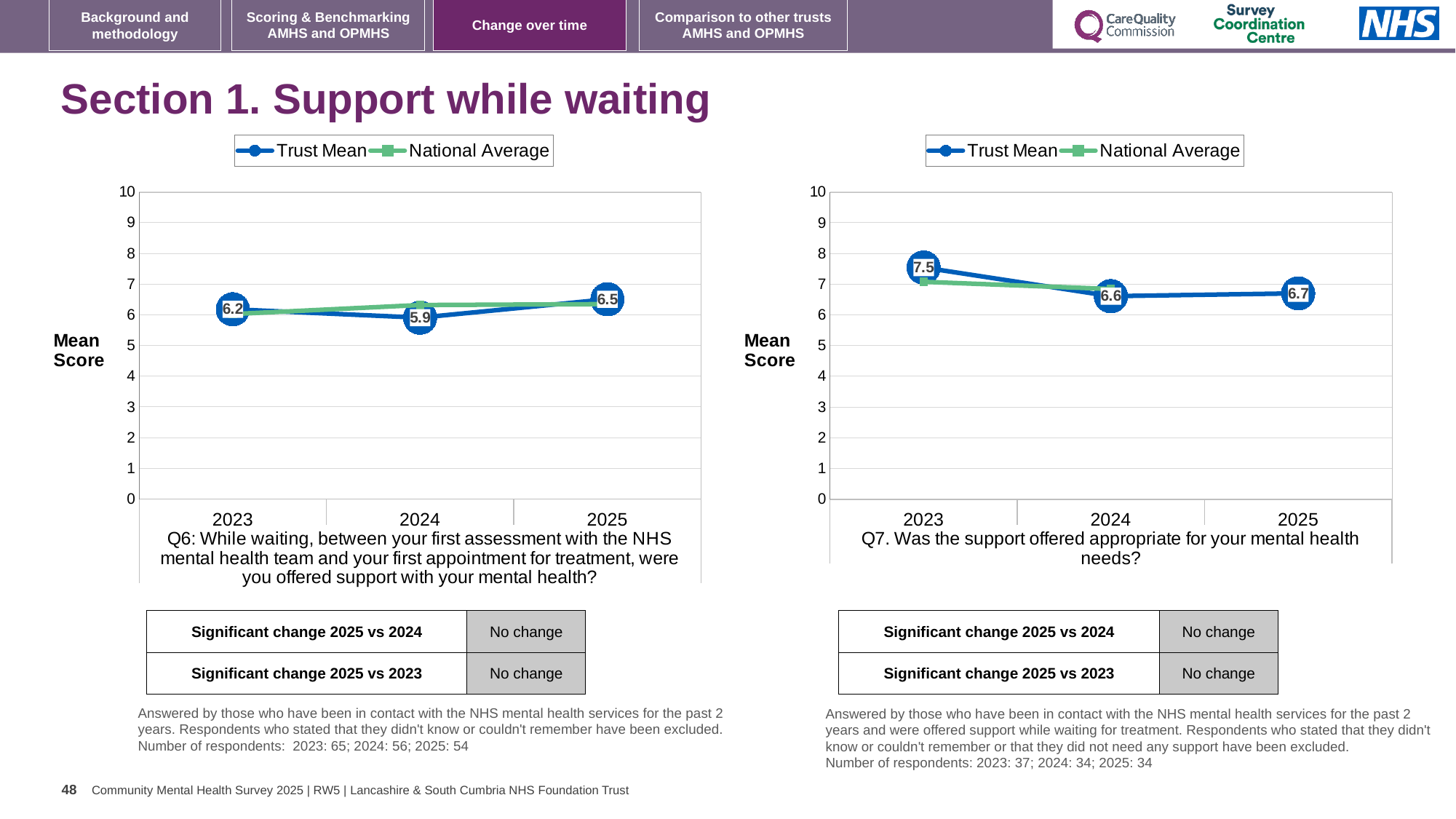
On the Q6 chart (left), which year has the highest Trust Mean score? 2025 On the Q6 chart (left), what is the Trust Mean score for 2024? 5.9 On the Q6 chart (left), what is the Trust Mean score for 2025? 6.5 On the Q6 chart (left), what is the difference between the Trust Mean scores for 2025 and 2024? 0.6 On the Q7 chart (right), is the National Average for 2023 greater or less than 8? less On the Q6 chart (left), is the Trust Mean score for 2023 larger or smaller than the Trust Mean score for 2024? larger How many series does the legend of the Q6 chart (left) list? 2 On the Q7 chart (right), which year has the lowest Trust Mean score? 2024 On the Q7 chart (right), what is the Trust Mean score for 2024? 6.6 On the Q7 chart (right), what is the Trust Mean score for 2023? 7.5 On the Q7 chart (right), what is the difference between the Trust Mean scores for 2023 and 2024? 0.9 What type of chart is the Q7 chart (right)? Line chart